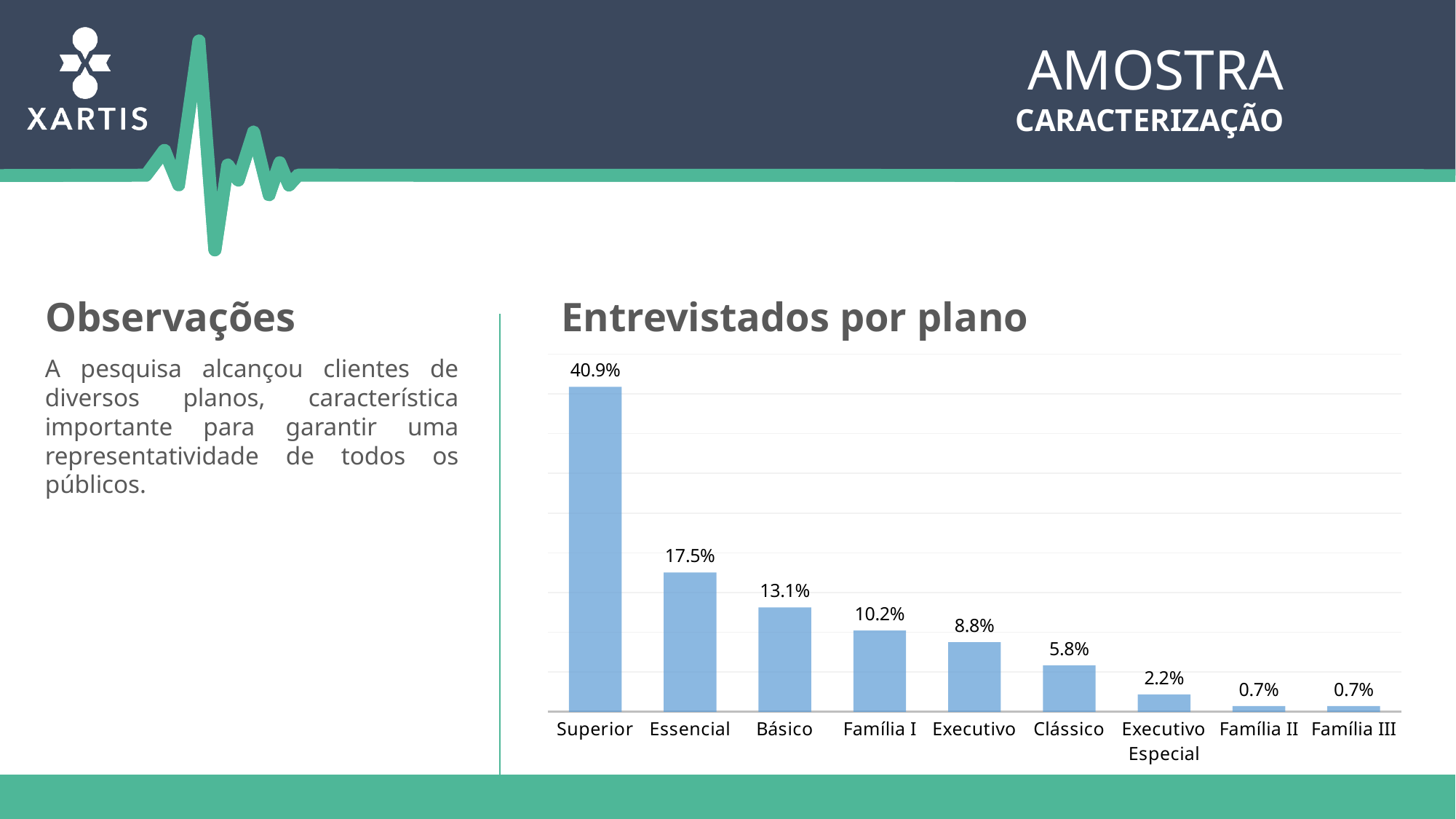
How many plans are shown on the x axis? 9 Which plan has the highest share of respondents? Superior Which is larger, the value for Executivo or the value for Clássico? Executivo What is the difference between the values for Básico and Família I? 2.9% What is the value for Essencial? 17.5% What is the value for Clássico? 5.8% What is the value for Superior? 40.9% What is the difference between the values for Superior and Essencial? 23.4% What is the value for Executivo Especial? 2.2% What kind of chart is shown on the slide? Bar chart What is the title of the chart? Entrevistados por plano Do the values rise or fall from left to right along the x axis? Fall